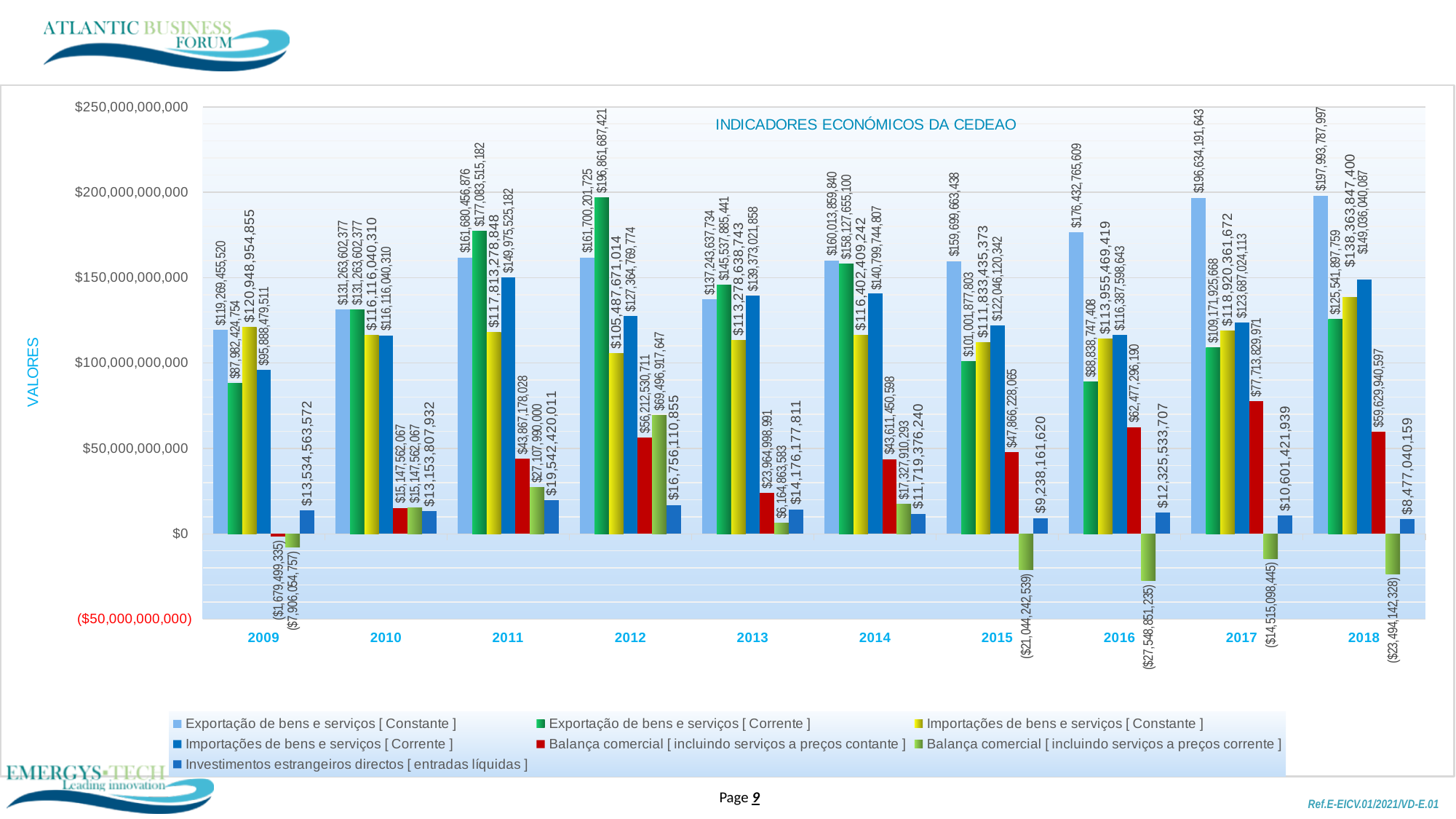
In which year is Balança comercial [ incluindo serviços a preços corrente ] lowest? 2016 What is the value of Balança comercial [ incluindo serviços a preços corrente ] in 2016? ($27,548,851,235) In 2016, which is larger: Exportação de bens e serviços [ Constante ] or Exportação de bens e serviços [ Corrente ]? Exportação de bens e serviços [ Constante ] How many years are shown on the x axis? 10 What is the difference between Exportação de bens e serviços [ Constante ] and Importações de bens e serviços [ Constante ] in 2010? $15,147,562,067 What type of chart is shown on the slide? Bar chart What is the value of Investimentos estrangeiros directos [ entradas líquidas ] in 2011? $19,542,420,011 In which year is Exportação de bens e serviços [ Corrente ] highest? 2012 Does Exportação de bens e serviços [ Constante ] rise or fall from 2015 to 2018? Rise How many series does the legend list? 7 What is the title of the chart? INDICADORES ECONÓMICOS DA CEDEAO What is the value of Exportação de bens e serviços [ Corrente ] in 2012? $196,861,687,421